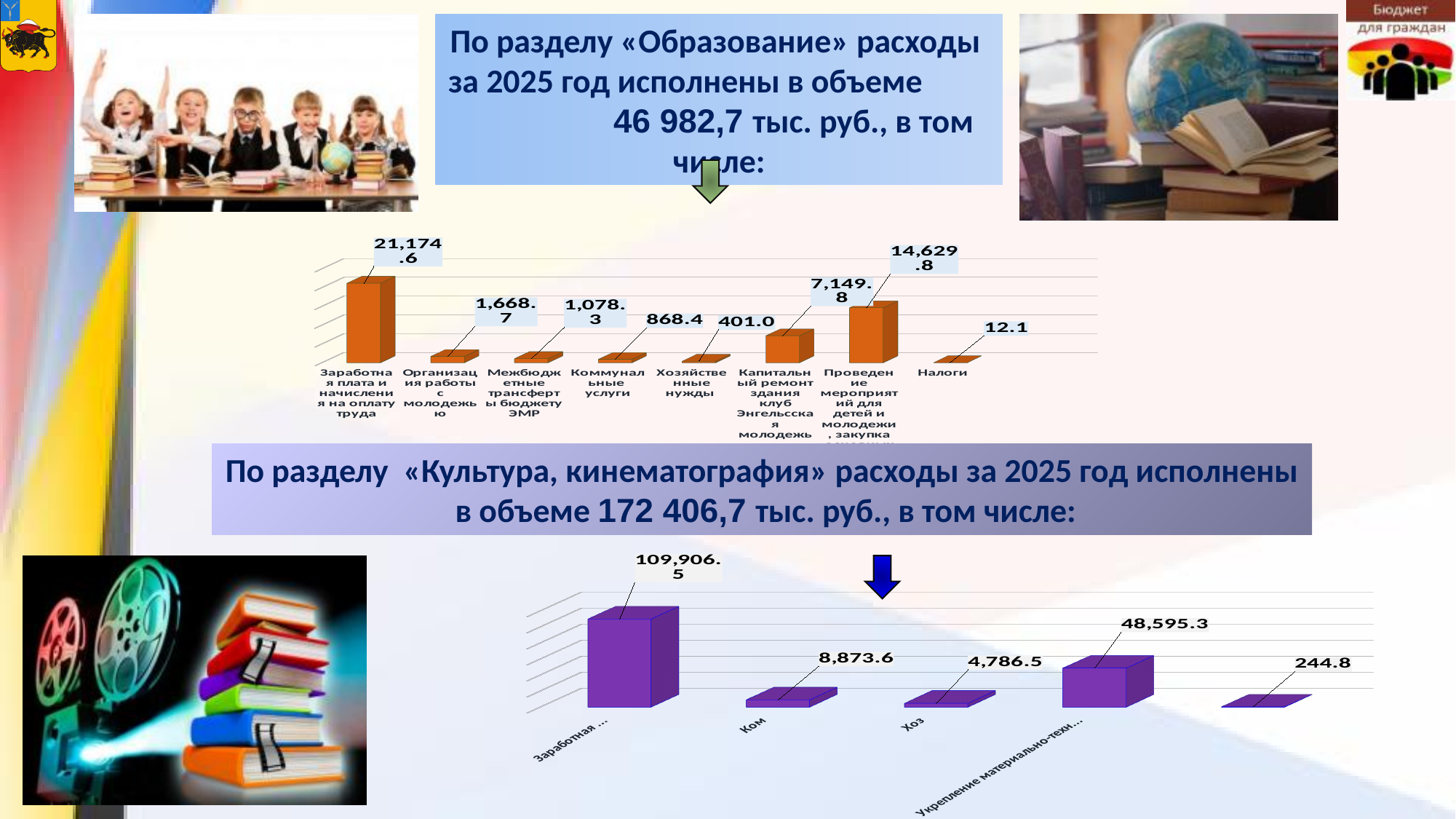
In the top chart (Образование), how many categories are shown? 8 What type of chart is the bottom chart (Культура, кинематография)? Bar chart In the top chart (Образование), what is the value for Налоги? 12.1 In the bottom chart (Культура, кинематография), what is the difference between Ком and Хоз? 4,087.1 In the top chart (Образование), which is larger: Капитальный ремонт здания клуб Энгельсская молодежь or Проведение мероприятий для детей и молодежи? Проведение мероприятий для детей и молодежи In the bottom chart (Культура, кинематография), what is the value for Заработная плата? 109,906.5 In the top chart (Образование), which category has the lowest value? Налоги In the bottom chart (Культура, кинематография), what is the value for Укрепление материально-технической базы? 48,595.3 In the top chart (Образование), what is the value for Хозяйственные нужды? 401.0 In the top chart (Образование), which category has the highest value? Заработная плата и начисления на оплату труда In the top chart (Образование), what is the value for Коммунальные услуги? 868.4 In the top chart (Образование), what is the difference between Организация работы с молодежью and Межбюджетные трансферты бюджету ЭМР? 590.4